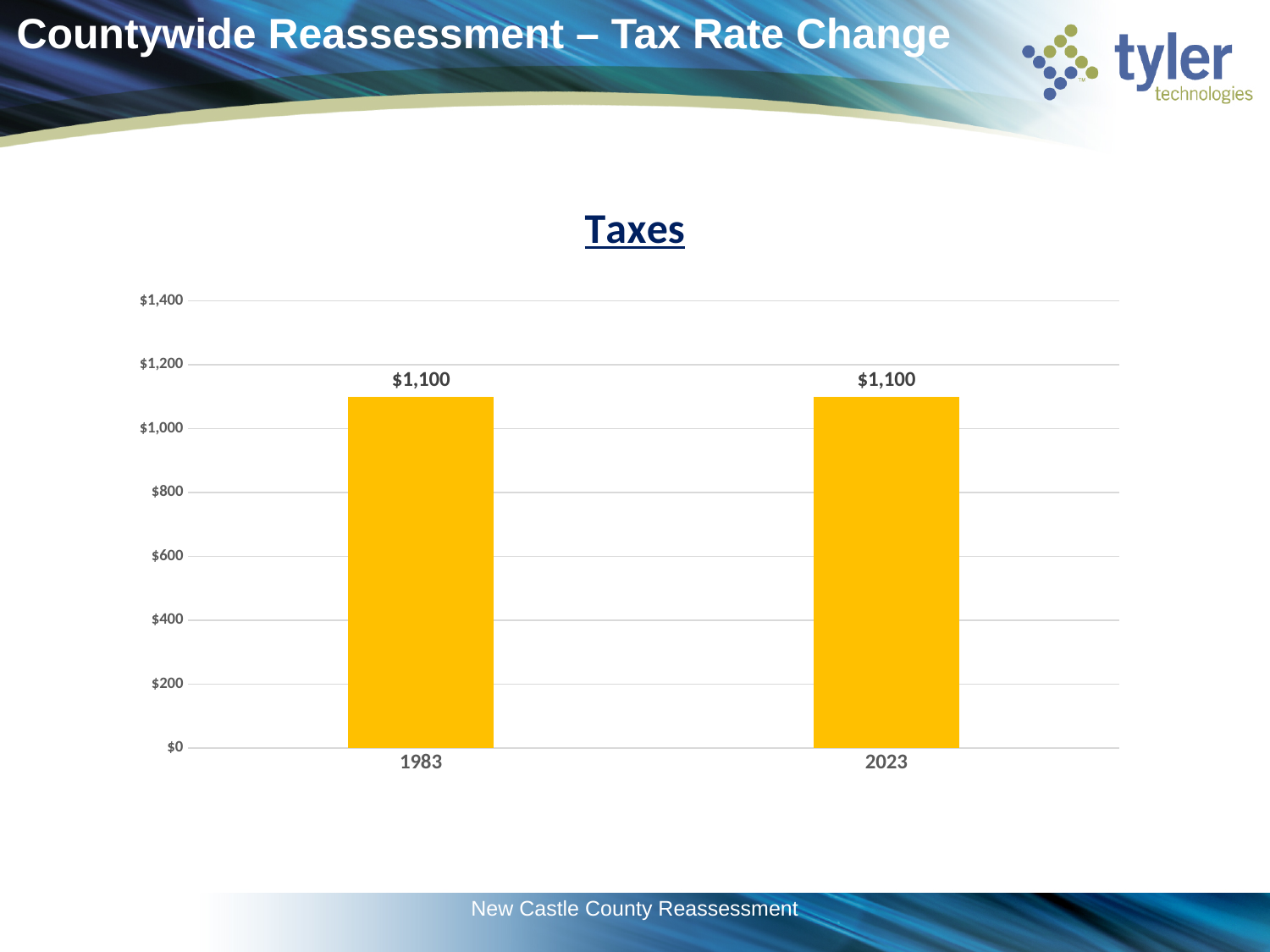
What is the value for 2023 in the Taxes chart? $1,100 Is the value for 1983 greater or less than $1,000? greater Is the value for 2023 greater or less than $1,200? less What is the difference between the 1983 and 2023 values in the Taxes chart? $0 How many categories are shown on the x axis of the Taxes chart? 2 What is the title of the chart? Taxes What is the highest value shown on the y axis of the Taxes chart? $1,400 What is the value for 1983 in the Taxes chart? $1,100 Do the values rise, fall, or stay the same from 1983 to 2023? Stay the same What kind of chart is shown on the slide? Bar chart What colour are the bars in the Taxes chart? Yellow